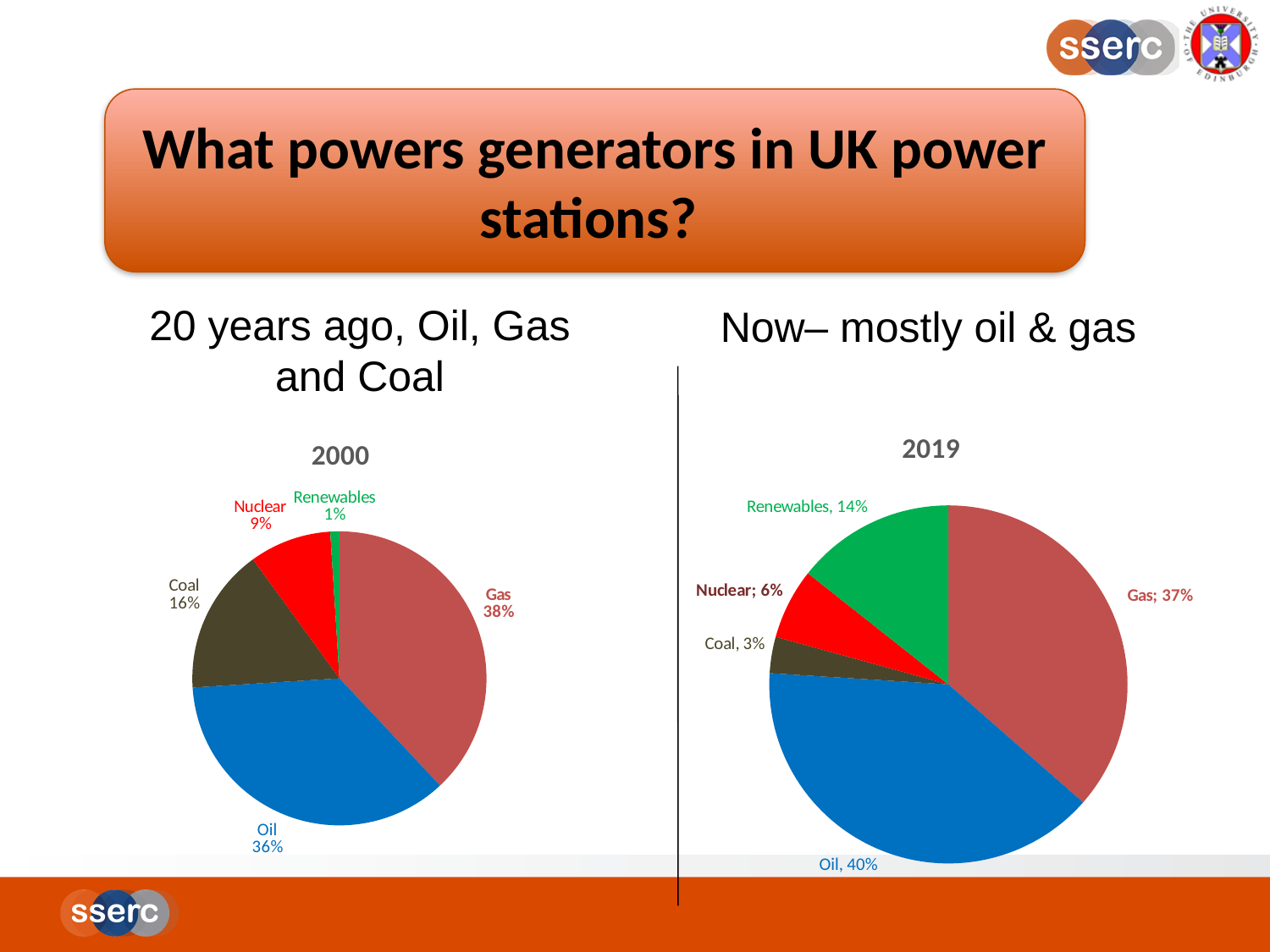
In the 2019 pie chart, what share does Renewables have? 14% In the 2000 pie chart, what share does Gas have? 38% What is the difference between the Coal share in the 2000 chart and the Coal share in the 2019 chart? 13% In the 2019 pie chart, which category has the smallest share? Coal In the 2019 pie chart, which is larger, the share for Nuclear or the share for Renewables? Renewables What type of chart is the 2019 chart? Pie chart In the 2000 pie chart, which category has the largest share? Gas In the 2019 pie chart, what share does Oil have? 40% In the 2019 pie chart, which category has the largest share? Oil In the 2000 pie chart, what share does Coal have? 16% How many categories are shown in the 2000 pie chart? 5 In the 2000 pie chart, which category has the smallest share? Renewables